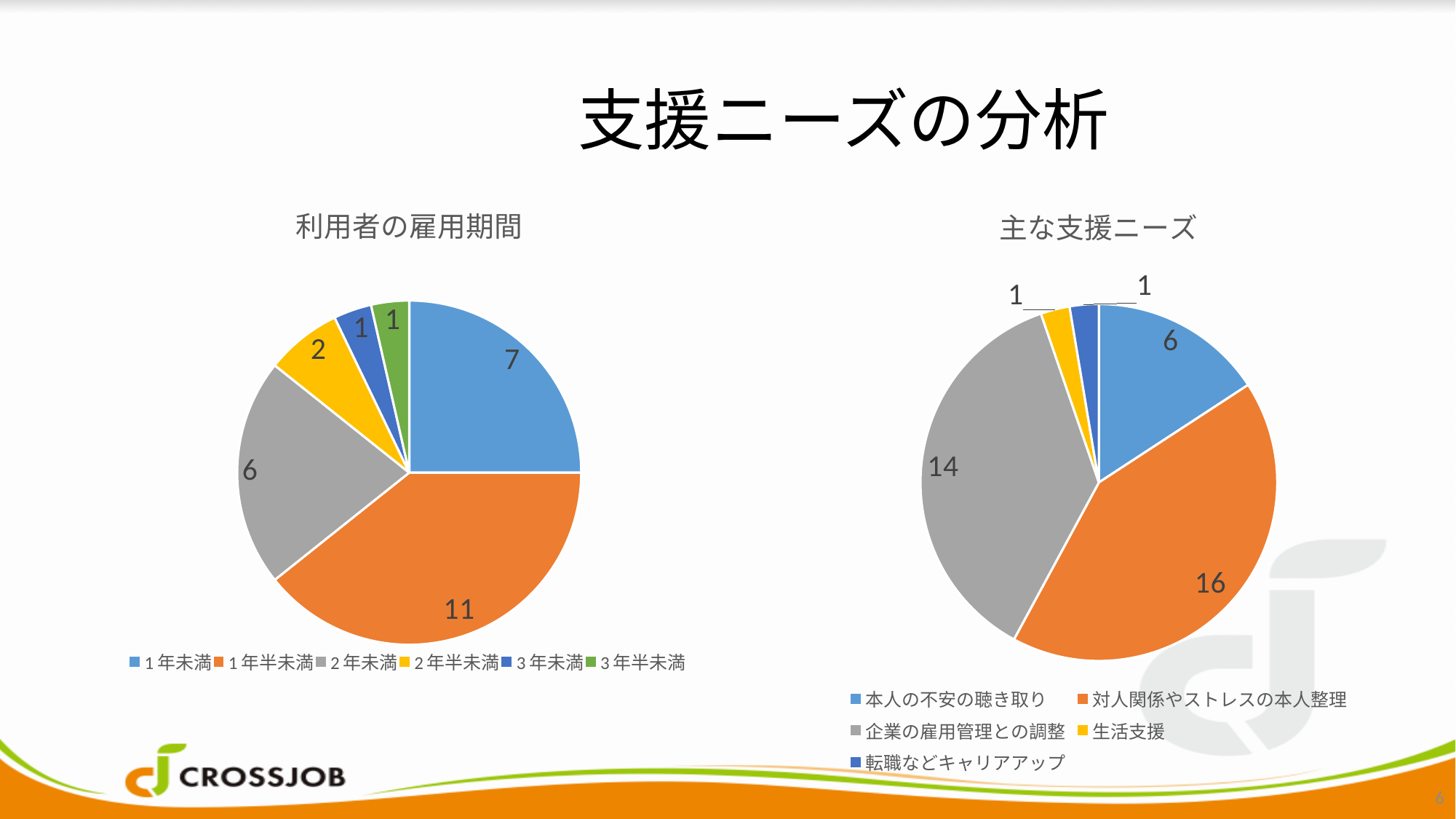
In the 利用者の雇用期間 chart, what is the difference between the values for 1年半未満 and 1年未満? 4 In the 利用者の雇用期間 chart, which category has the largest slice? 1年半未満 In the 主な支援ニーズ chart, what is the value for 本人の不安の聴き取り? 6 In the 主な支援ニーズ chart, what is the difference between the values for 対人関係やストレスの本人整理 and 本人の不安の聴き取り? 10 In the 主な支援ニーズ chart, what is the value for 企業の雇用管理との調整? 14 In the 主な支援ニーズ chart, which is larger: 対人関係やストレスの本人整理 or 企業の雇用管理との調整? 対人関係やストレスの本人整理 In the 利用者の雇用期間 chart, how many categories does the legend list? 6 In the 利用者の雇用期間 chart, what is the value for 1年半未満? 11 In the 主な支援ニーズ chart, which category has the largest slice? 対人関係やストレスの本人整理 In the 利用者の雇用期間 chart, what is the value for 2年半未満? 2 In the 利用者の雇用期間 chart, what share of the total does 1年未満 represent? 25% What type of chart is used for 主な支援ニーズ? Pie chart